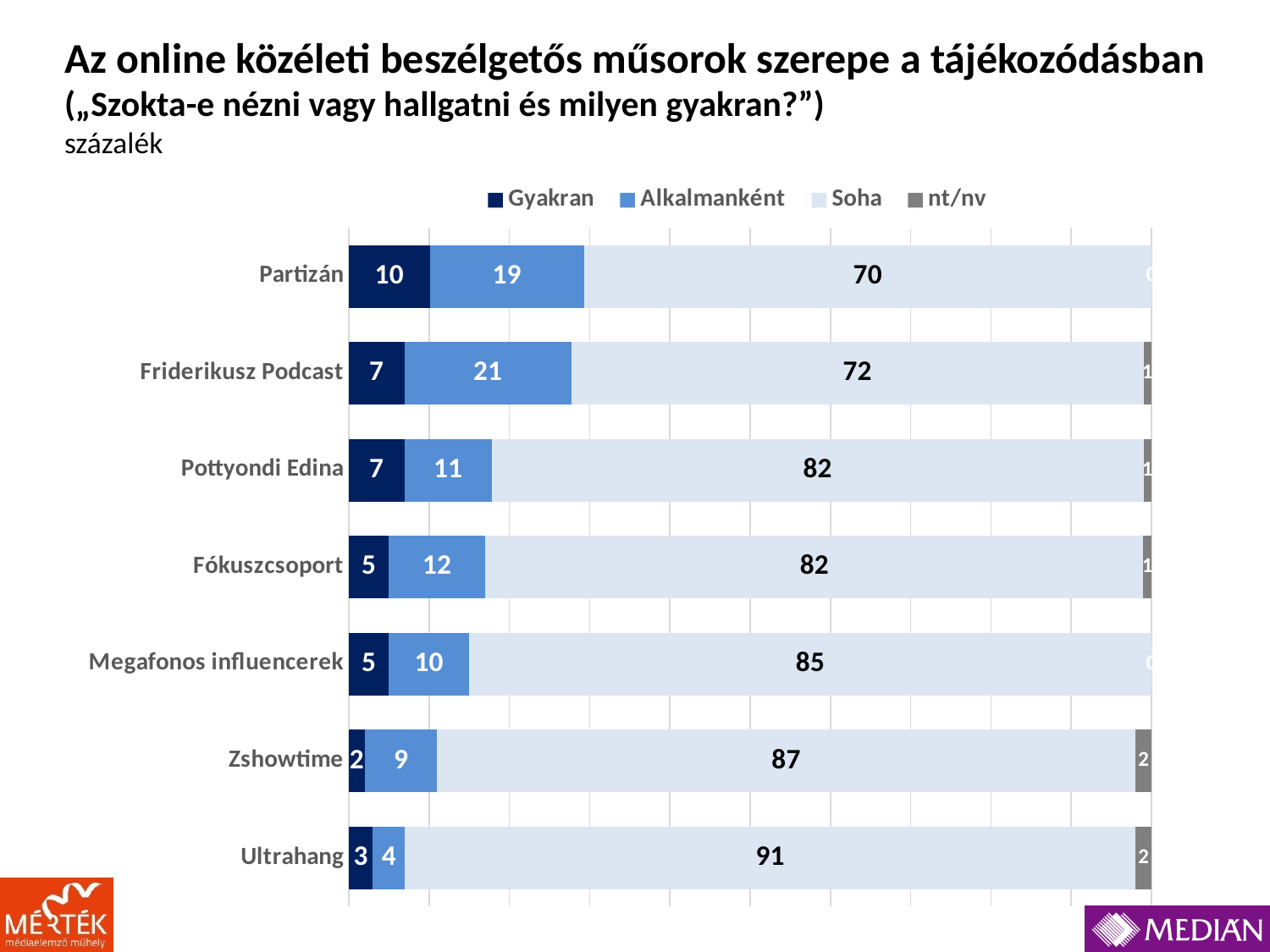
How many programmes (categories) are shown in the chart? 7 What type of chart is shown on the slide? stacked bar chart How many series does the legend list? 4 What is the 'Alkalmanként' value for Zshowtime? 9 What is the 'Gyakran' value for Partizán? 10 What is the 'Alkalmanként' value for Friderikusz Podcast? 21 Which programme has the highest 'Soha' value? Ultrahang Which is larger: the 'Alkalmanként' value for Pottyondi Edina or for Fókuszcsoport? Fókuszcsoport Which series is shown in the darkest blue colour? Gyakran What is the 'Soha' value for Ultrahang? 91 Which programme has the lowest 'Soha' value? Partizán What is the difference between the 'Soha' values for Megafonos influencerek and Partizán? 15